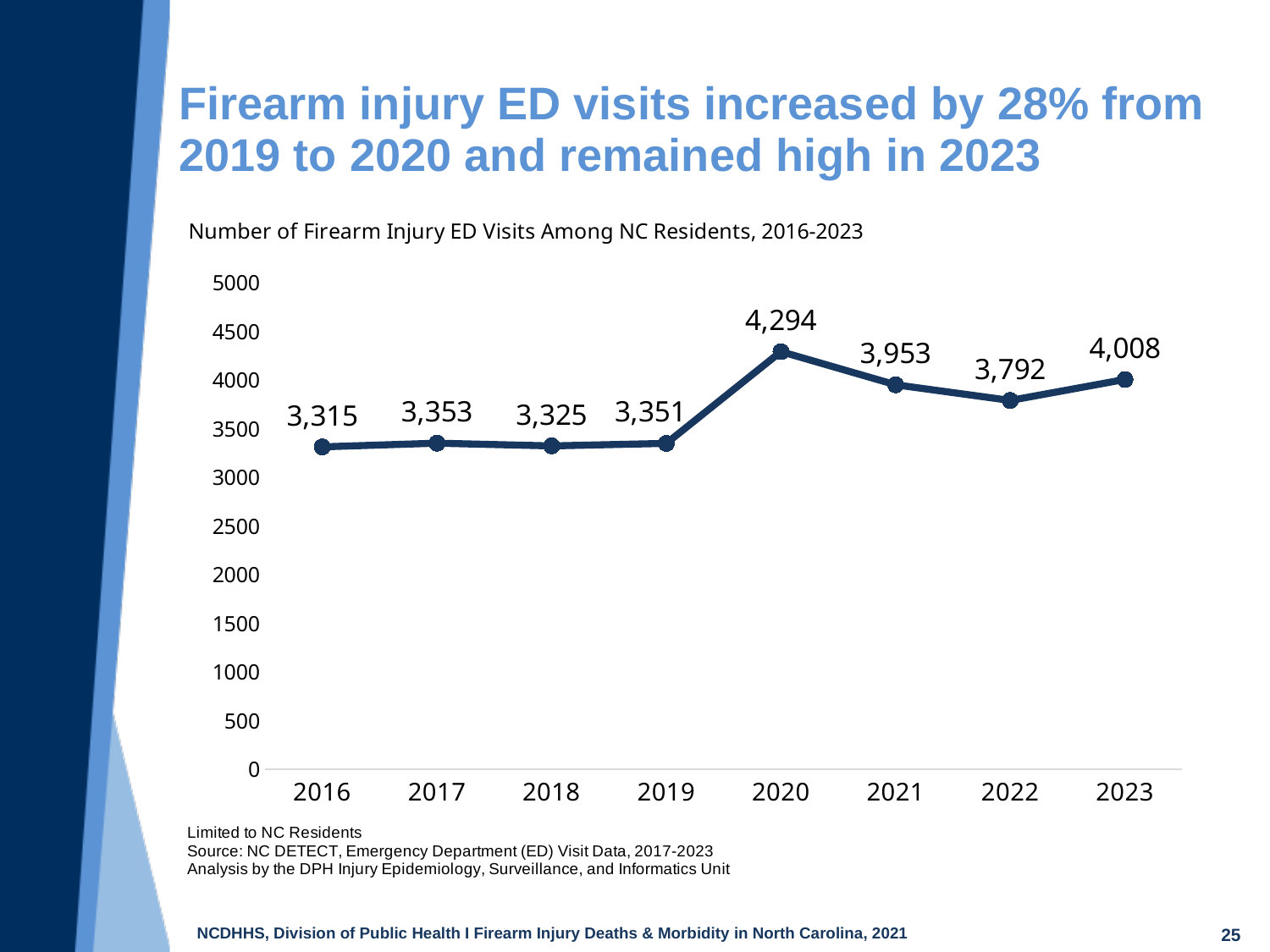
What kind of chart is shown on the slide? Line chart Which year had more firearm injury ED visits, 2021 or 2022? 2021 What is the number of firearm injury ED visits in 2016? 3,315 What is the number of firearm injury ED visits in 2023? 4,008 Did the number of firearm injury ED visits rise or fall from 2022 to 2023? Rise What is the title of the chart? Number of Firearm Injury ED Visits Among NC Residents, 2016-2023 Which year has the lowest number of firearm injury ED visits? 2016 What is the difference in firearm injury ED visits between 2020 and 2019? 943 Is the value for 2022 greater or less than 3500? greater How many years are plotted on the chart? 8 What is the number of firearm injury ED visits in 2020? 4,294 Which year has the highest number of firearm injury ED visits? 2020